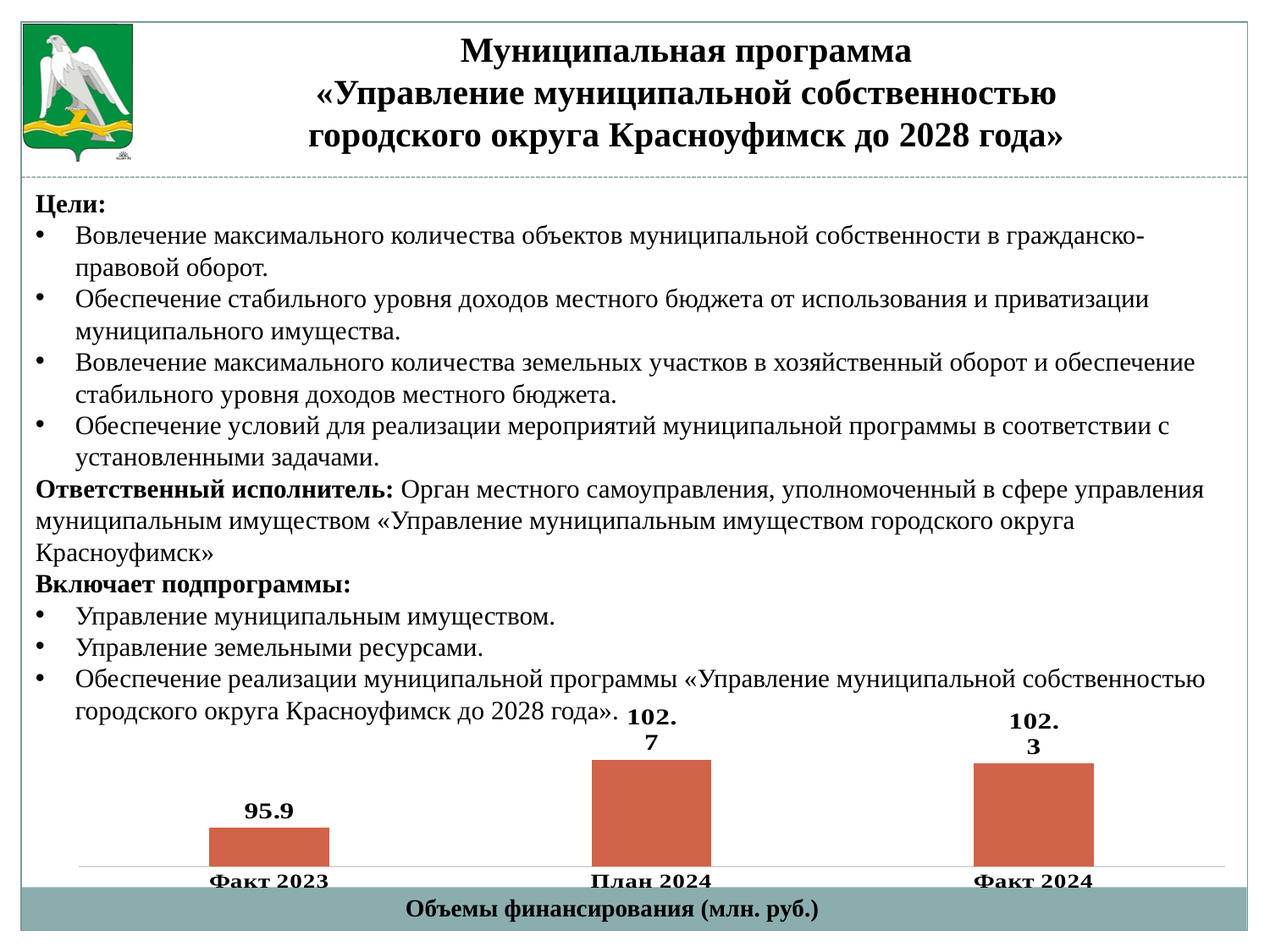
What is the value for План 2024 in the chart Объемы финансирования (млн. руб.)? 102.7 Which category has the highest value in the chart Объемы финансирования (млн. руб.)? План 2024 What is the value for Факт 2024 in the chart Объемы финансирования (млн. руб.)? 102.3 What is the difference between the values for Факт 2024 and Факт 2023 in the chart Объемы финансирования (млн. руб.)? 6.4 What is the value for Факт 2023 in the chart Объемы финансирования (млн. руб.)? 95.9 What is the title of the chart at the bottom of the slide? Объемы финансирования (млн. руб.) What is the difference between the values for План 2024 and Факт 2024 in the chart Объемы финансирования (млн. руб.)? 0.4 How many categories are shown in the chart Объемы финансирования (млн. руб.)? 3 Which category has the lowest value in the chart Объемы финансирования (млн. руб.)? Факт 2023 Which is larger in the chart Объемы финансирования (млн. руб.): the value for Факт 2023 or the value for Факт 2024? Факт 2024 What kind of chart is used for Объемы финансирования (млн. руб.)? Bar chart What is the difference between the values for План 2024 and Факт 2023 in the chart Объемы финансирования (млн. руб.)? 6.8